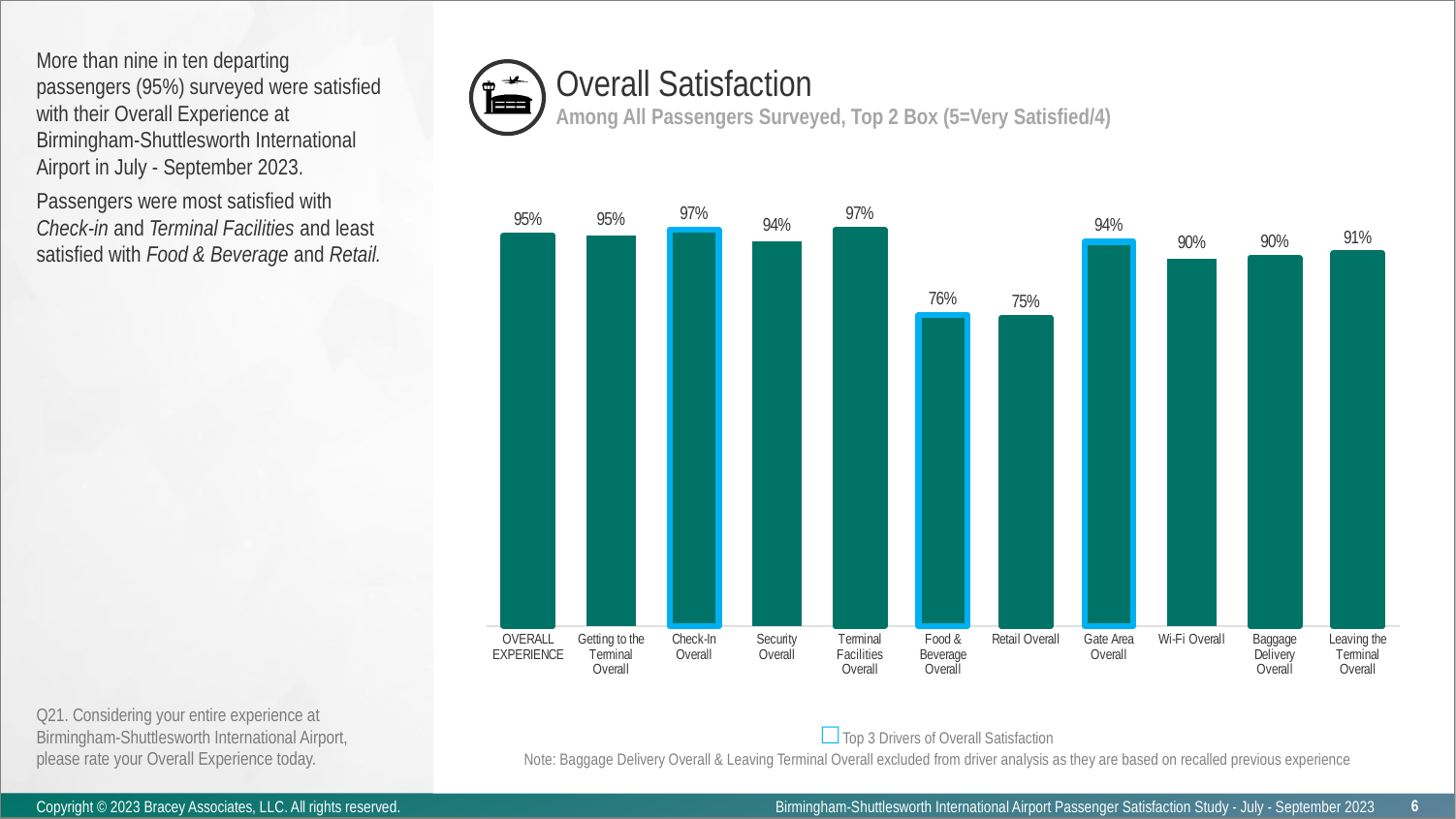
What is the value for Retail Overall? 75% How many categories are shown in the chart? 11 What is the value for Gate Area Overall? 94% What is the value for Leaving the Terminal Overall? 91% What is the difference between Check-In Overall and Food & Beverage Overall? 21% Which category has the lowest value? Retail Overall Which is larger, Security Overall or Baggage Delivery Overall? Security Overall What is the difference between Overall Experience and Wi-Fi Overall? 5% What kind of chart is shown on the slide? Bar chart What is the value for Overall Experience? 95% Which is larger, Food & Beverage Overall or Retail Overall? Food & Beverage Overall What does the blue outline around some bars indicate, according to the legend? Top 3 Drivers of Overall Satisfaction